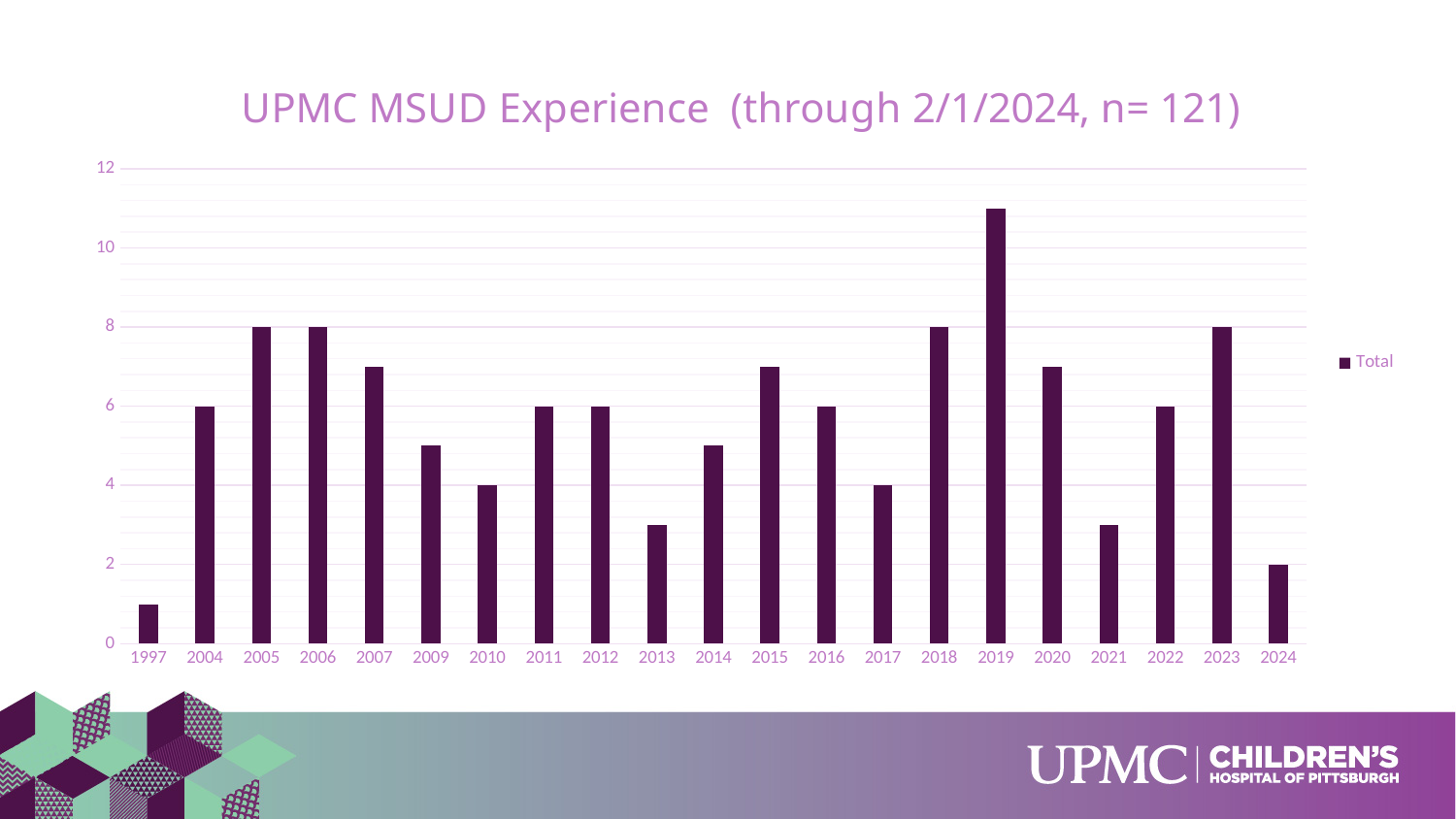
Which year has a larger total, 2018 or 2021? 2018 Which year has the highest total? 2019 How many years are shown on the x axis? 21 Which year has the lowest total? 1997 What is the total for 2010? 4 What is the total for 2024? 2 What is the title of the chart? UPMC MSUD Experience (through 2/1/2024, n= 121) Is the value for 2013 greater or less than 4? less What type of chart is shown on the slide? bar chart What is the total for 2005? 8 How many series does the legend list? 1 Is the value for 2019 greater or less than 10? greater